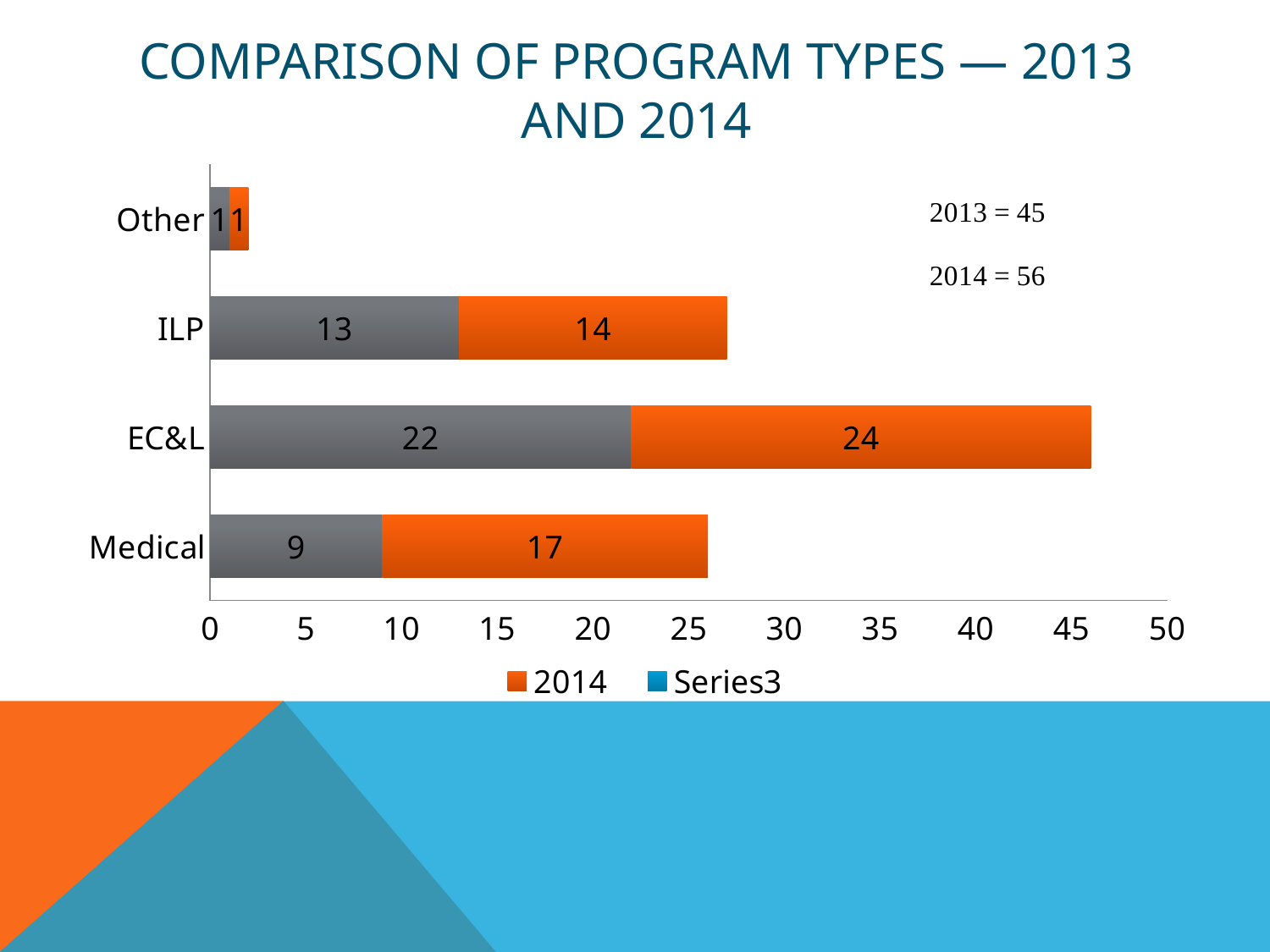
Which category has the highest 2014 value? EC&L What is the total of the stacked bar for Medical? 26 How many series does the legend list? 2 What kind of chart is shown on the slide? bar chart How many categories are shown on the chart? 4 What is the 2014 value for EC&L? 24 Which category has the lowest 2014 value? Other What is the 2014 value for Medical? 17 What is the difference between the 2014 values for EC&L and ILP? 10 What is the total of the stacked bar for EC&L? 46 What is the value of the gray segment for ILP? 13 Which has the larger 2014 value, Medical or ILP? Medical